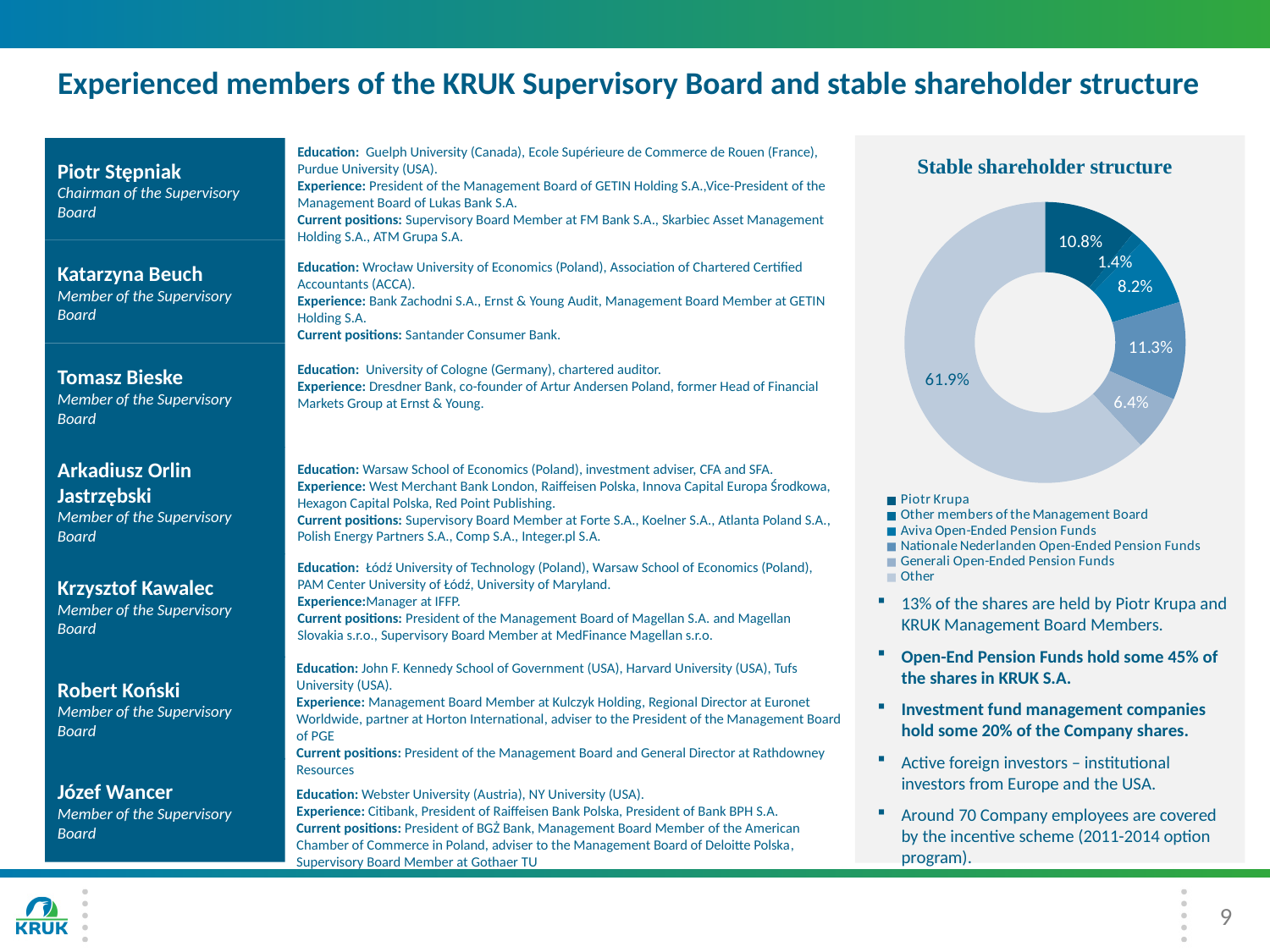
In the 'Stable shareholder structure' chart, what share is held by Generali Open-Ended Pension Funds? 6.4% Which category has the largest slice in the 'Stable shareholder structure' chart? Other Which category has the smallest slice in the 'Stable shareholder structure' chart? Other members of the Management Board How many categories does the legend of the 'Stable shareholder structure' chart list? 6 What is the title of the pie chart on the slide? Stable shareholder structure In the 'Stable shareholder structure' chart, what share is held by Aviva Open-Ended Pension Funds? 8.2% In the 'Stable shareholder structure' chart, what share of shares is held by Piotr Krupa? 10.8% In the 'Stable shareholder structure' chart, what share is held by other members of the Management Board? 1.4% In the 'Stable shareholder structure' chart, how many percentage points larger is the Nationale Nederlanden slice than the Aviva slice? 3.1 percentage points In the 'Stable shareholder structure' chart, what share is held by Nationale Nederlanden Open-Ended Pension Funds? 11.3% In the 'Stable shareholder structure' chart, which is larger: the Piotr Krupa slice or the Generali Open-Ended Pension Funds slice? Piotr Krupa What type of chart is shown under the title 'Stable shareholder structure'? Pie chart (donut)